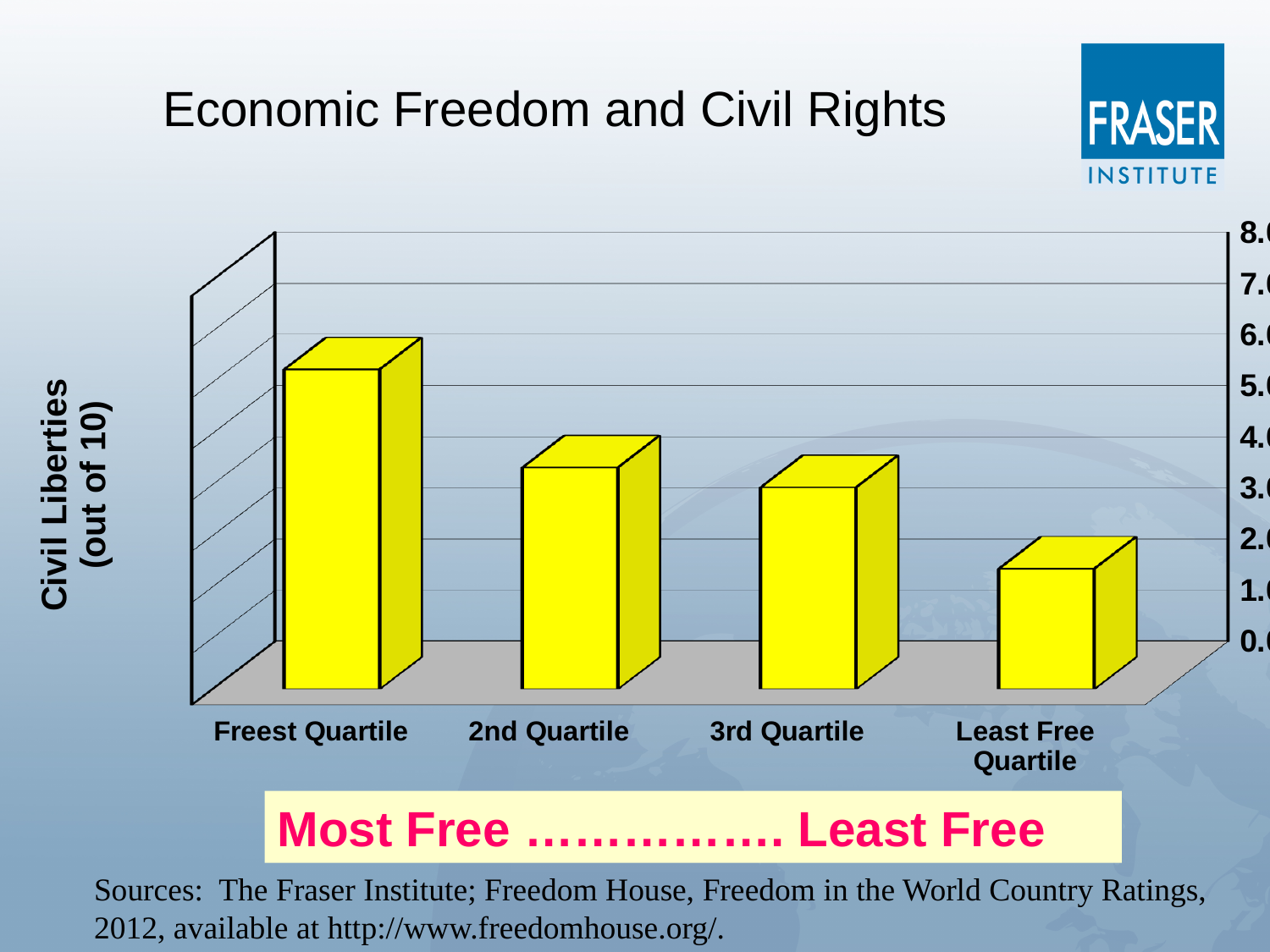
What kind of chart is shown on the slide? bar chart Is the value for the 3rd Quartile greater or less than 5.0? less Is the value for the 2nd Quartile greater or less than 2.0? greater Which quartile has the highest civil liberties score? Freest Quartile Is the value for the Freest Quartile greater or less than 4.0? greater Which quartile has the lowest civil liberties score? Least Free Quartile Which has a higher civil liberties score, the 3rd Quartile or the Least Free Quartile? 3rd Quartile What is the label on the vertical axis of the chart? Civil Liberties (out of 10) How many quartile categories are plotted on the chart? 4 Which has a higher civil liberties score, the Freest Quartile or the 2nd Quartile? Freest Quartile Do the bar values rise or fall moving from the Freest Quartile to the Least Free Quartile? fall